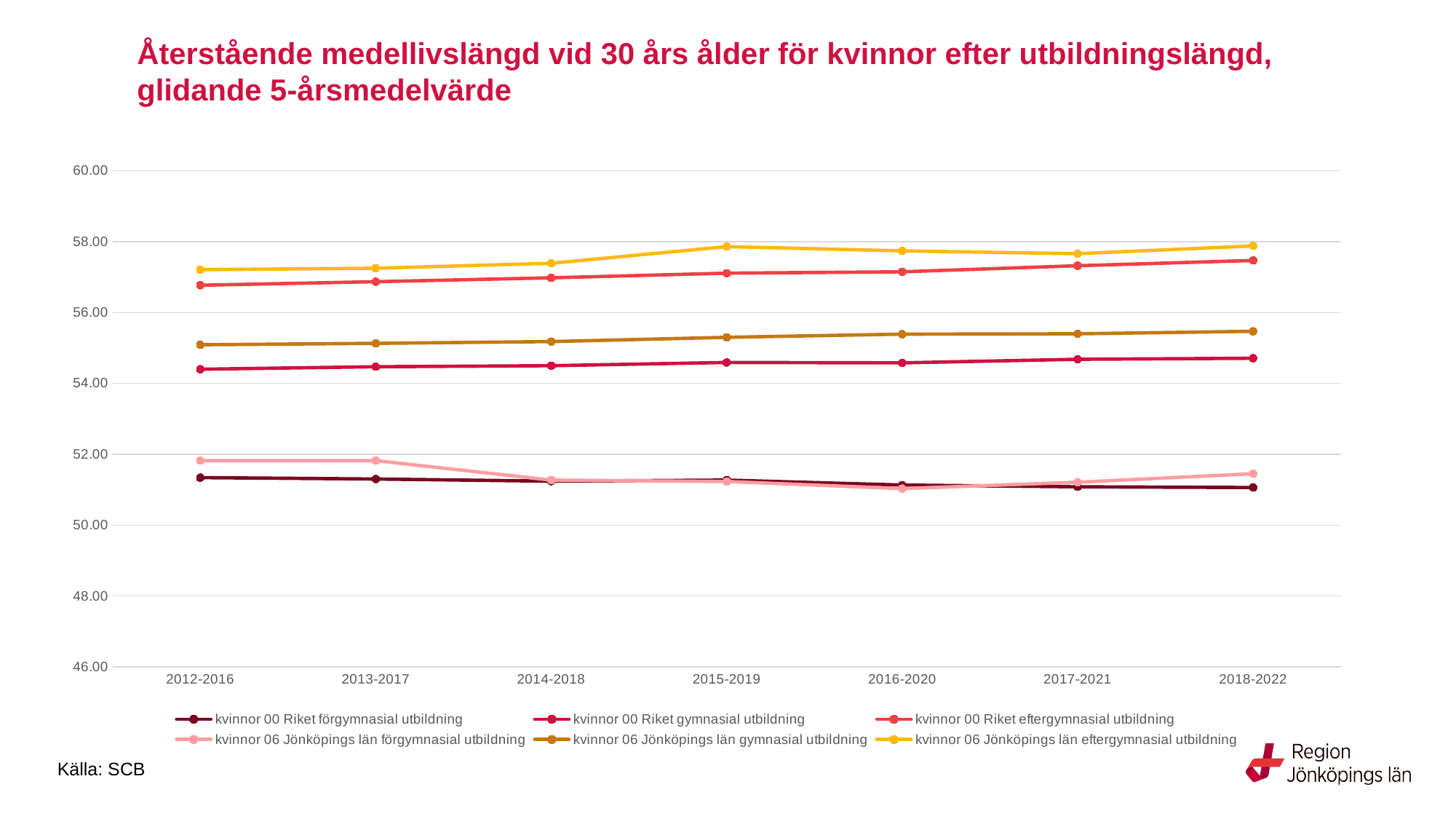
Does the line for kvinnor 00 Riket eftergymnasial utbildning rise or fall from 2012-2016 to 2018-2022? rise What is the title of the chart? Återstående medellivslängd vid 30 års ålder för kvinnor efter utbildningslängd, glidande 5-årsmedelvärde Is the value for kvinnor 00 Riket förgymnasial utbildning in 2018-2022 greater or less than 52.00? less In 2012-2016, which is higher: kvinnor 06 Jönköpings län förgymnasial utbildning or kvinnor 00 Riket förgymnasial utbildning? kvinnor 06 Jönköpings län förgymnasial utbildning How many series does the legend list? 6 What source is cited for the chart? SCB Which series has the highest values across the chart? kvinnor 06 Jönköpings län eftergymnasial utbildning Is the value for kvinnor 06 Jönköpings län gymnasial utbildning in 2018-2022 greater or less than 54.00? greater Which series has the lowest value in 2018-2022? kvinnor 00 Riket förgymnasial utbildning Is the value for kvinnor 06 Jönköpings län eftergymnasial utbildning in 2015-2019 greater or less than 56.00? greater What kind of chart is shown on the slide? line chart How many periods are shown on the x axis? 7